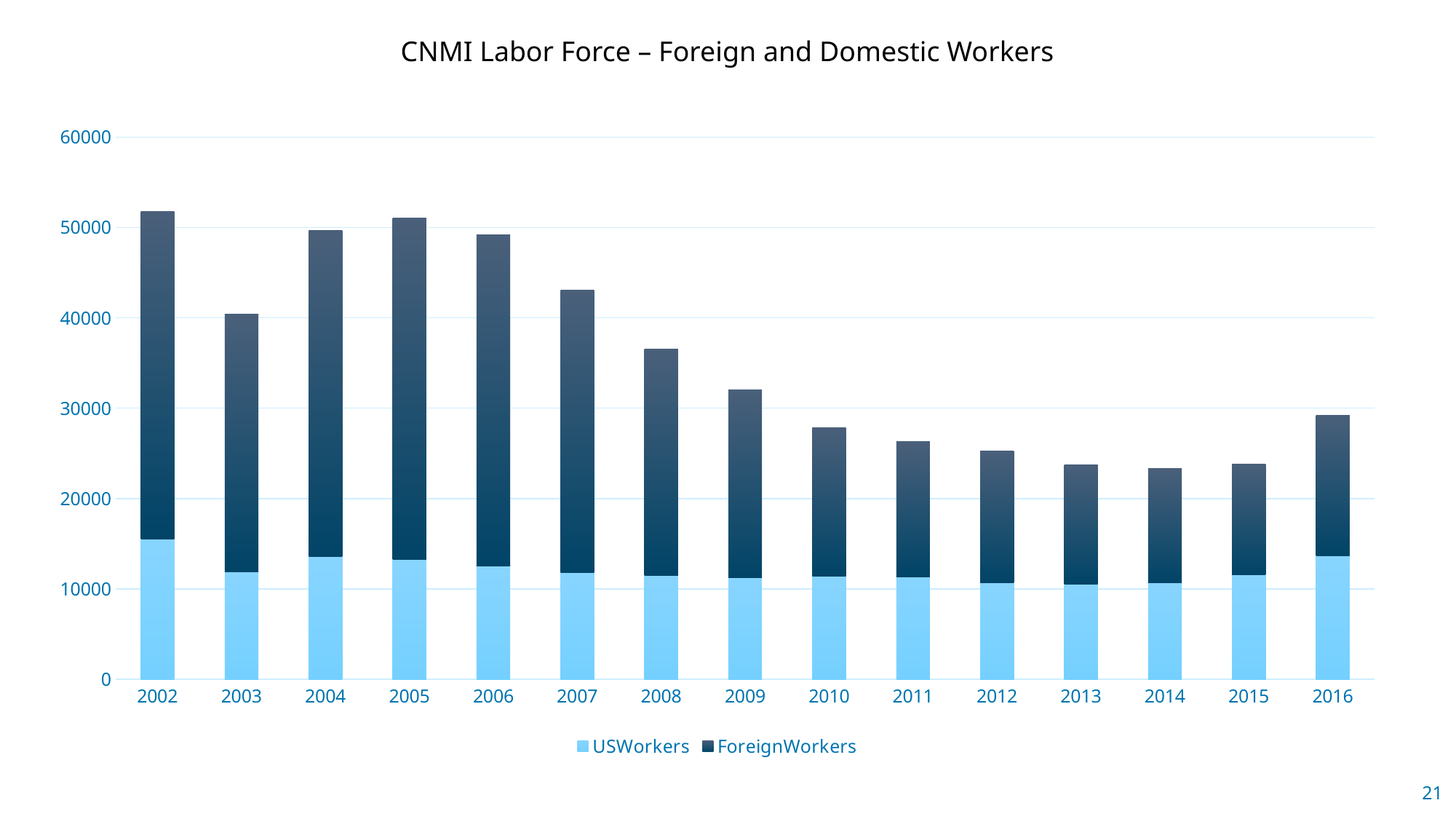
How many years are shown on the x axis of the chart? 15 Which year has the highest USWorkers value? 2002 Is the total labor force for 2002 greater or less than 50000? greater Is the USWorkers value for 2002 greater or less than 10000? greater Is the total labor force for 2008 greater or less than 40000? less What kind of chart is shown on the slide? Stacked bar chart Which year has the larger total labor force, 2002 or 2003? 2002 What is the title of the chart? CNMI Labor Force – Foreign and Domestic Workers Does the total labor force generally rise or fall from 2002 to 2015? fall Which series is shown in light blue at the bottom of each bar? USWorkers How many series does the legend list? 2